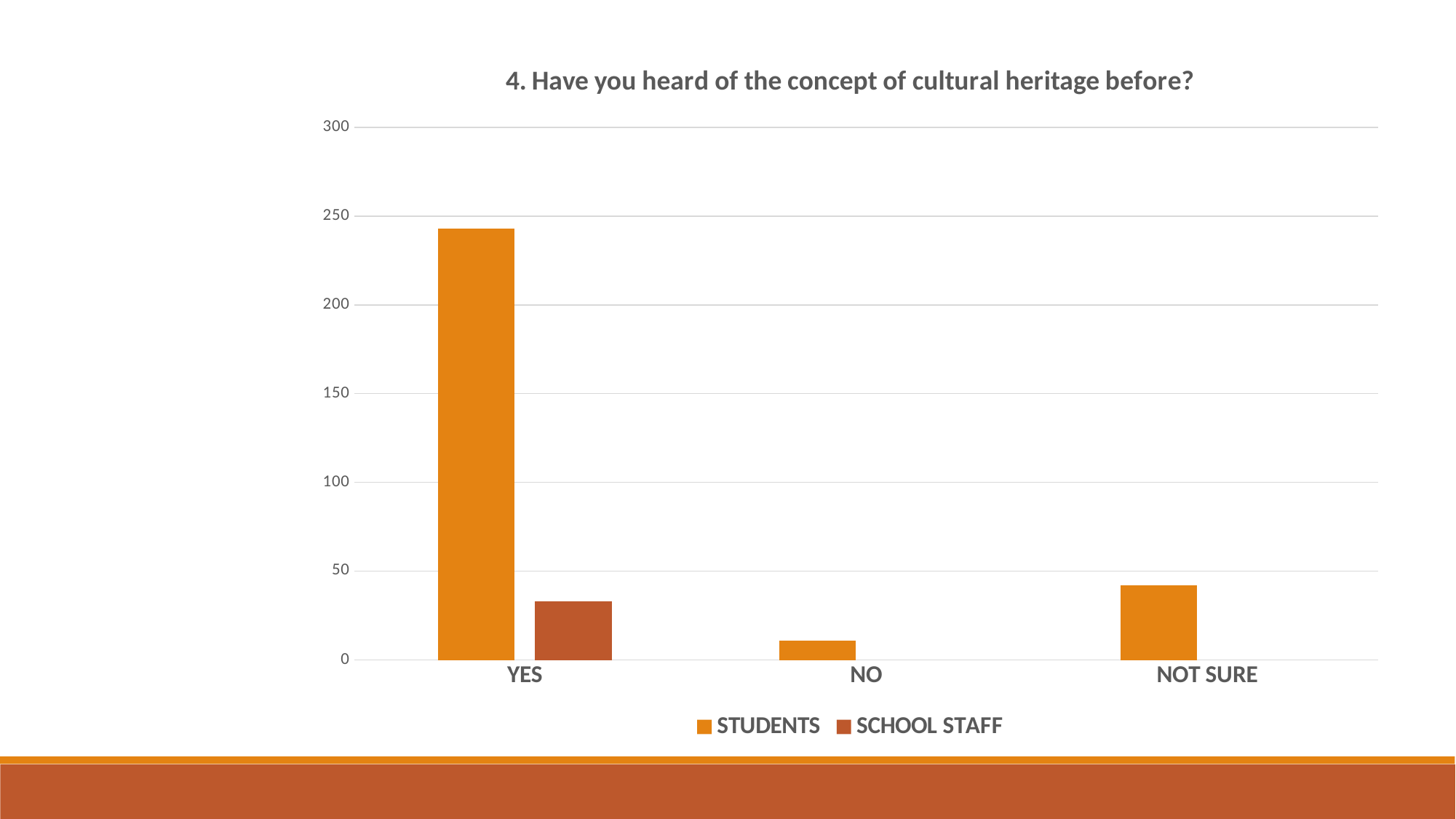
Is the STUDENTS value for YES greater or less than 200? greater Which is larger for STUDENTS, the value for NO or the value for NOT SURE? NOT SURE Which category has the highest value for STUDENTS? YES Is the STUDENTS value for YES greater or less than 250? less What kind of chart is shown on the slide? bar chart Is the STUDENTS value for NOT SURE greater or less than 50? less For the YES category, which series has the larger value, STUDENTS or SCHOOL STAFF? STUDENTS What is the title of the chart? 4. Have you heard of the concept of cultural heritage before? How many categories are shown on the x axis? 3 How many series does the legend list? 2 Which category has the lowest value for STUDENTS? NO